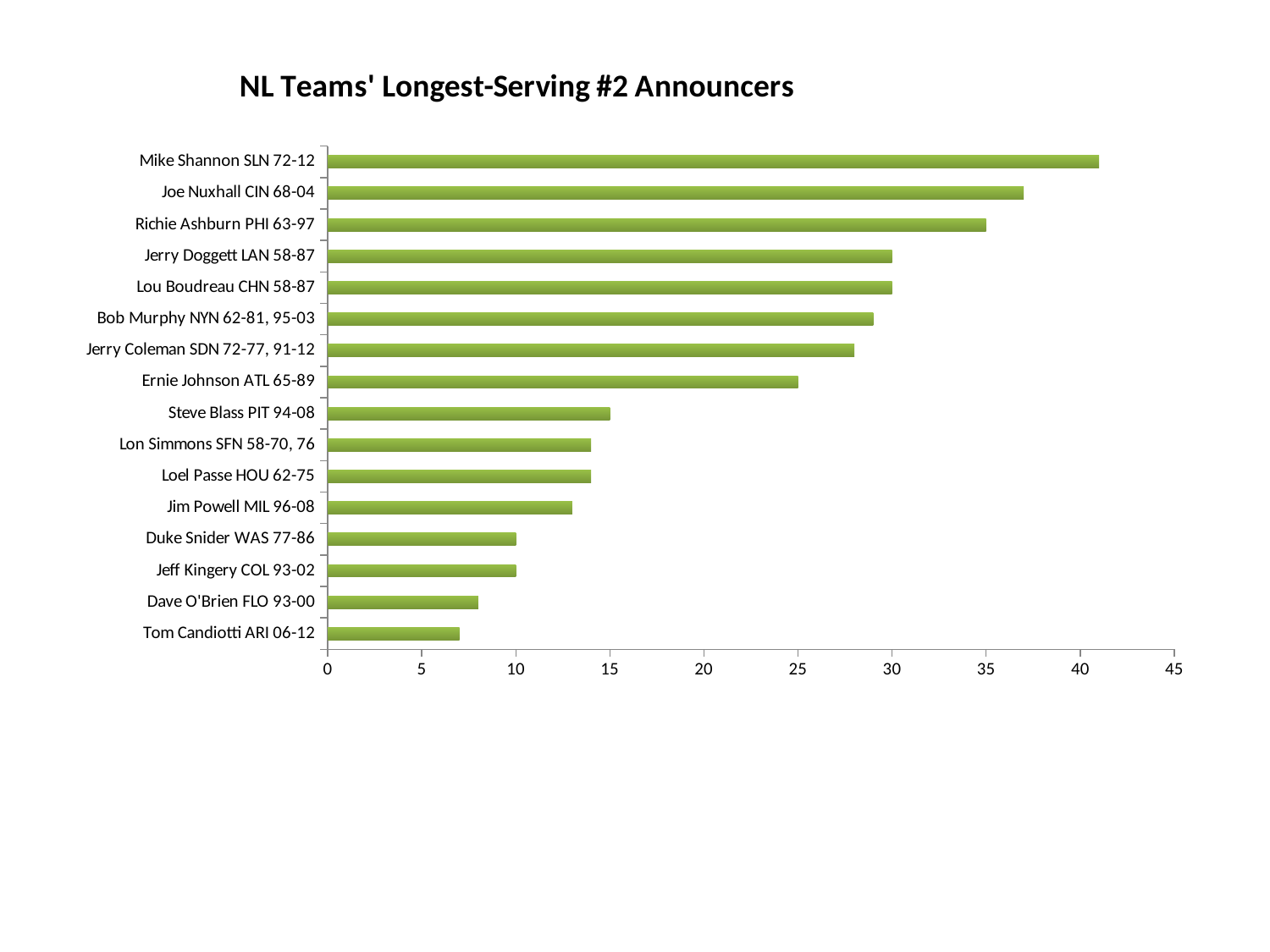
What is the value for Steve Blass PIT 94-08? 15 Is the value for Tom Candiotti ARI 06-12 greater or less than 10? less Which announcer has the shortest bar? Tom Candiotti ARI 06-12 How many announcers are listed in the chart? 16 Which announcer has the longest bar? Mike Shannon SLN 72-12 Is the value for Mike Shannon SLN 72-12 greater or less than 40? greater What is the title of the chart? NL Teams' Longest-Serving #2 Announcers What kind of chart is shown on the slide? bar chart What is the difference between the values for Jerry Doggett LAN 58-87 and Steve Blass PIT 94-08? 15 What is the value for Ernie Johnson ATL 65-89? 25 What is the value for Jerry Doggett LAN 58-87? 30 Which is larger, the value for Joe Nuxhall CIN 68-04 or the value for Richie Ashburn PHI 63-97? Joe Nuxhall CIN 68-04